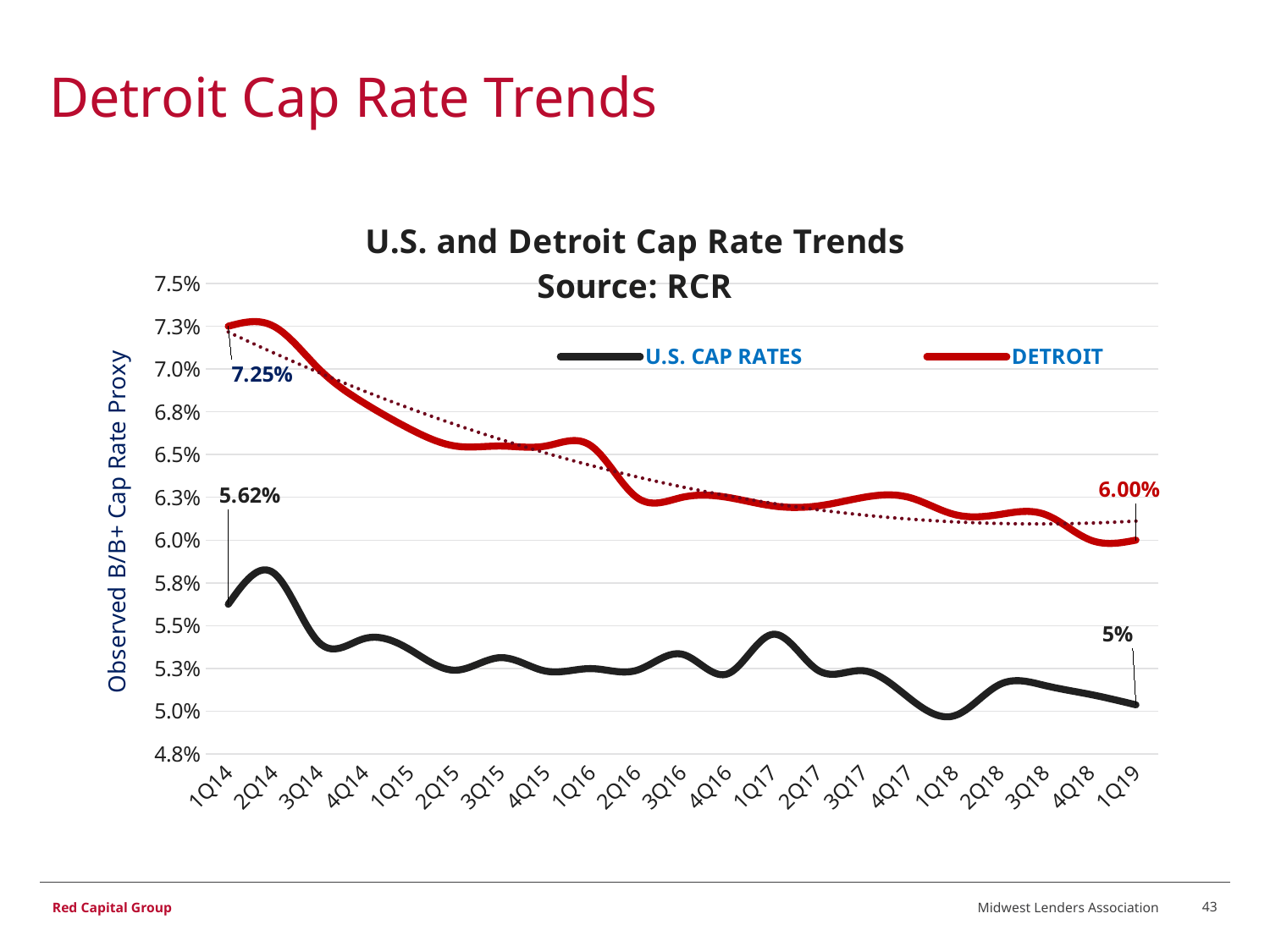
What is the Detroit cap rate in 1Q19? 6.00% What is the title of the chart? U.S. and Detroit Cap Rate Trends Source: RCR How many quarters are plotted along the x axis? 21 How many series does the legend list? 2 What is the U.S. cap rate in 1Q14? 5.62% Does the Detroit cap rate rise or fall from 1Q14 to 1Q19? fall What is the Detroit cap rate in 1Q14? 7.25% What is the U.S. cap rate in 1Q19? 5% Which series has the higher value in 1Q19, U.S. CAP RATES or DETROIT? DETROIT What kind of chart is shown on the slide? line chart What is the difference between the Detroit cap rate in 1Q14 and in 1Q19? 1.25%